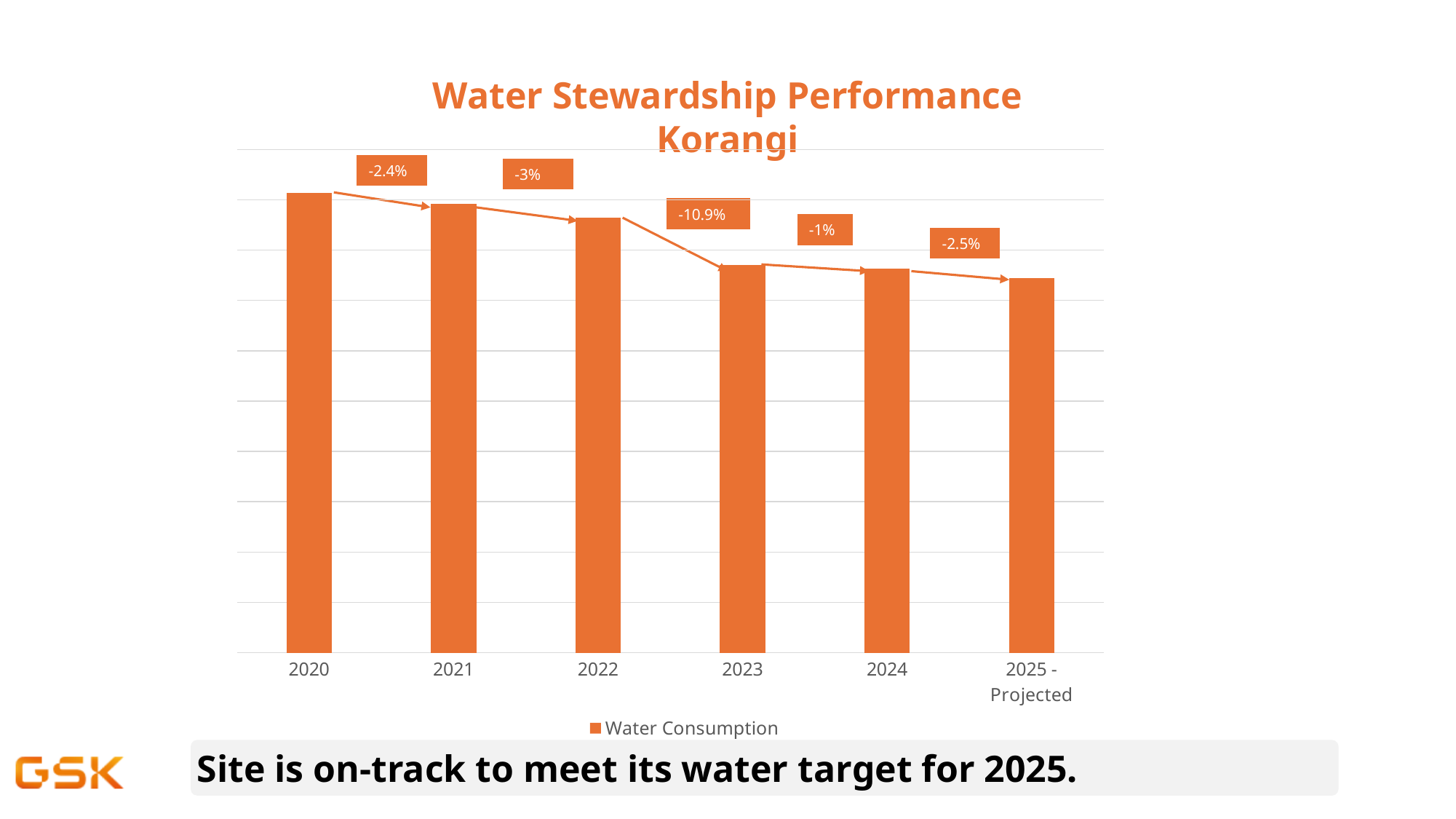
What percentage change is labelled between 2024 and 2025 - Projected? -2.5% What percentage change is labelled between 2022 and 2023? -10.9% What percentage change is labelled between 2020 and 2021? -2.4% Do the water consumption values rise or fall from 2020 to 2025 - Projected? Fall Which year has the highest water consumption bar? 2020 What series name is shown in the chart's legend? Water Consumption What is the title of the chart? Water Stewardship Performance Korangi Is the water consumption bar for 2020 taller or shorter than the bar for 2023? Taller Which year has the lowest water consumption bar? 2025 - Projected How many years (categories) are shown on the x axis of the chart? 6 How many series does the chart's legend list? 1 What type of chart is shown on the slide? Bar chart